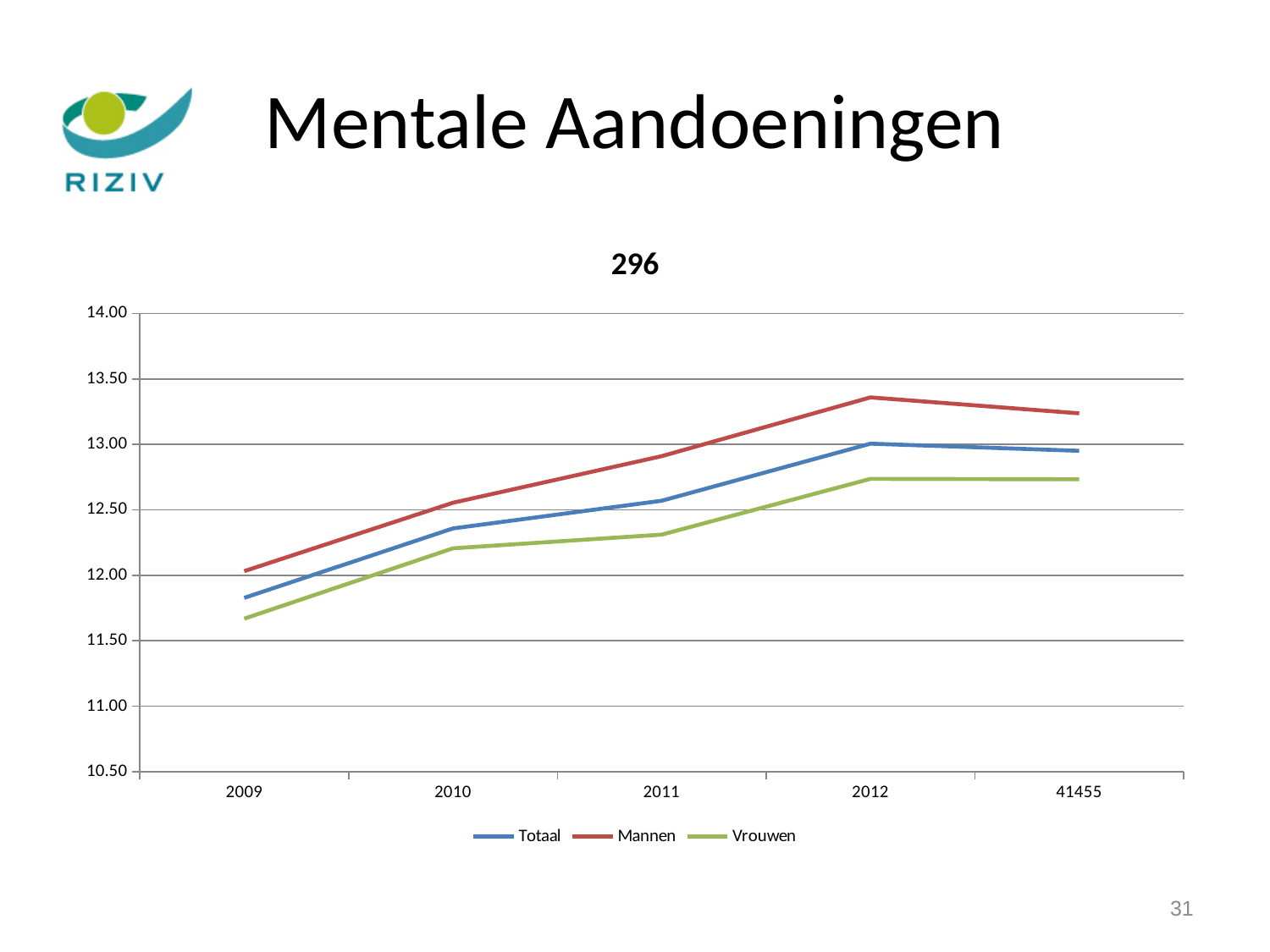
Is the value for Mannen in 2012 greater or less than 13.00? greater Is the value for Totaal in 2010 greater or less than 12.50? less Does the Mannen series rise or fall from 2009 to 2012? rise Which series has the highest value in 2012? Mannen Is the value for Vrouwen in 2009 greater or less than 12.00? less How many series does the legend list? 3 What kind of chart is shown on the slide? line chart Which series is shown in red in the legend? Mannen What is the title of the chart? 296 How many points are plotted along the x axis for each series? 5 Which series has the lowest value in 2009? Vrouwen